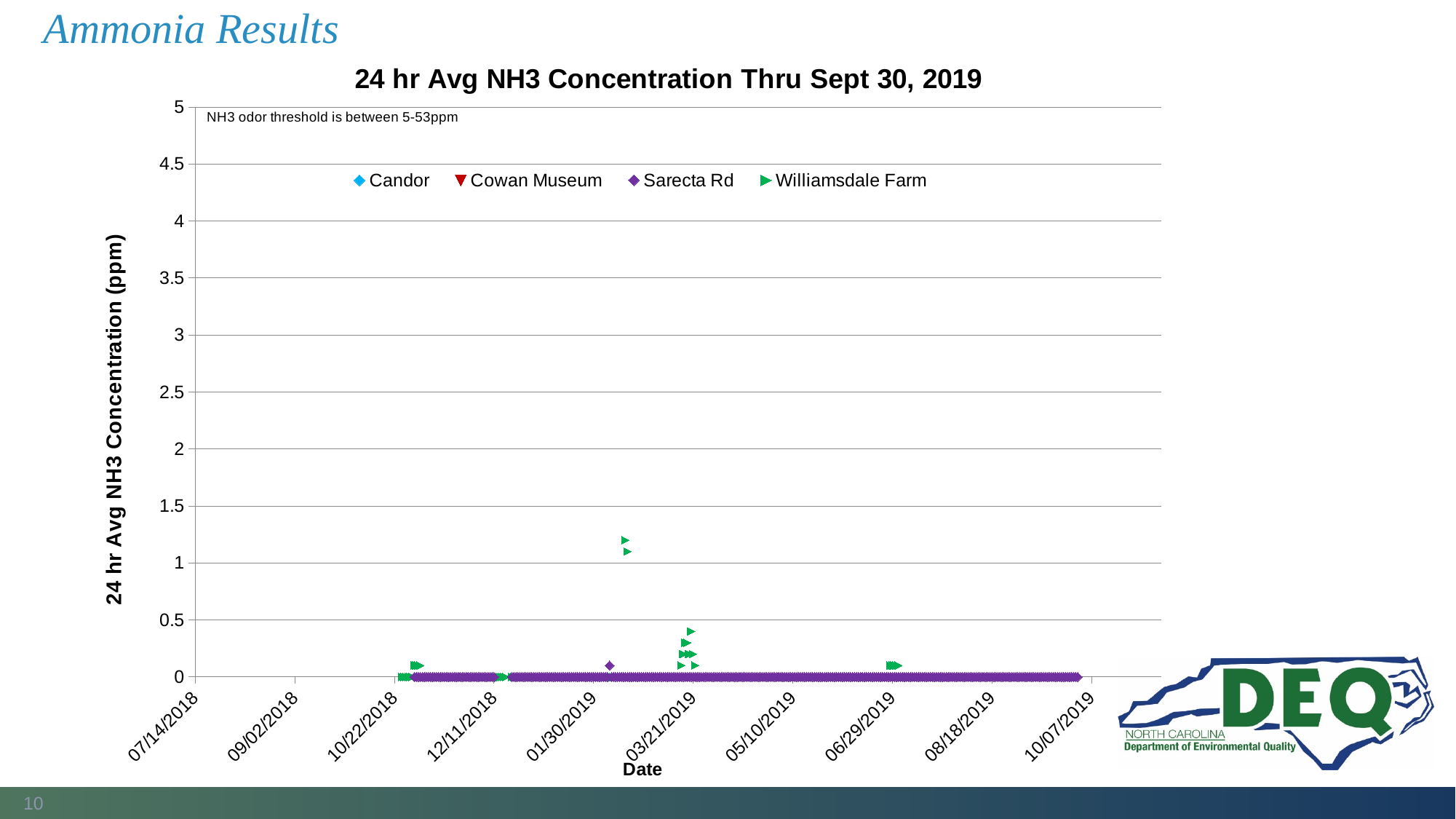
What is the title of the chart? 24 hr Avg NH3 Concentration Thru Sept 30, 2019 Which series has a higher maximum plotted value, Williamsdale Farm or Sarecta Rd? Williamsdale Farm Which series has the highest plotted value on the chart? Williamsdale Farm What kind of chart is shown on the slide? Scatter chart What is the first date label shown on the x axis? 07/14/2018 How many series does the chart legend list? 4 According to the note on the chart, what is the NH3 odor threshold range? between 5-53ppm What is the maximum value shown on the y axis? 5 Is the highest plotted value for Williamsdale Farm greater or less than 1.5? less Is the highest plotted value for Williamsdale Farm greater or less than 1? greater Is the highest plotted value for Sarecta Rd greater or less than 0.5? less What is the label of the y axis? 24 hr Avg NH3 Concentration (ppm)